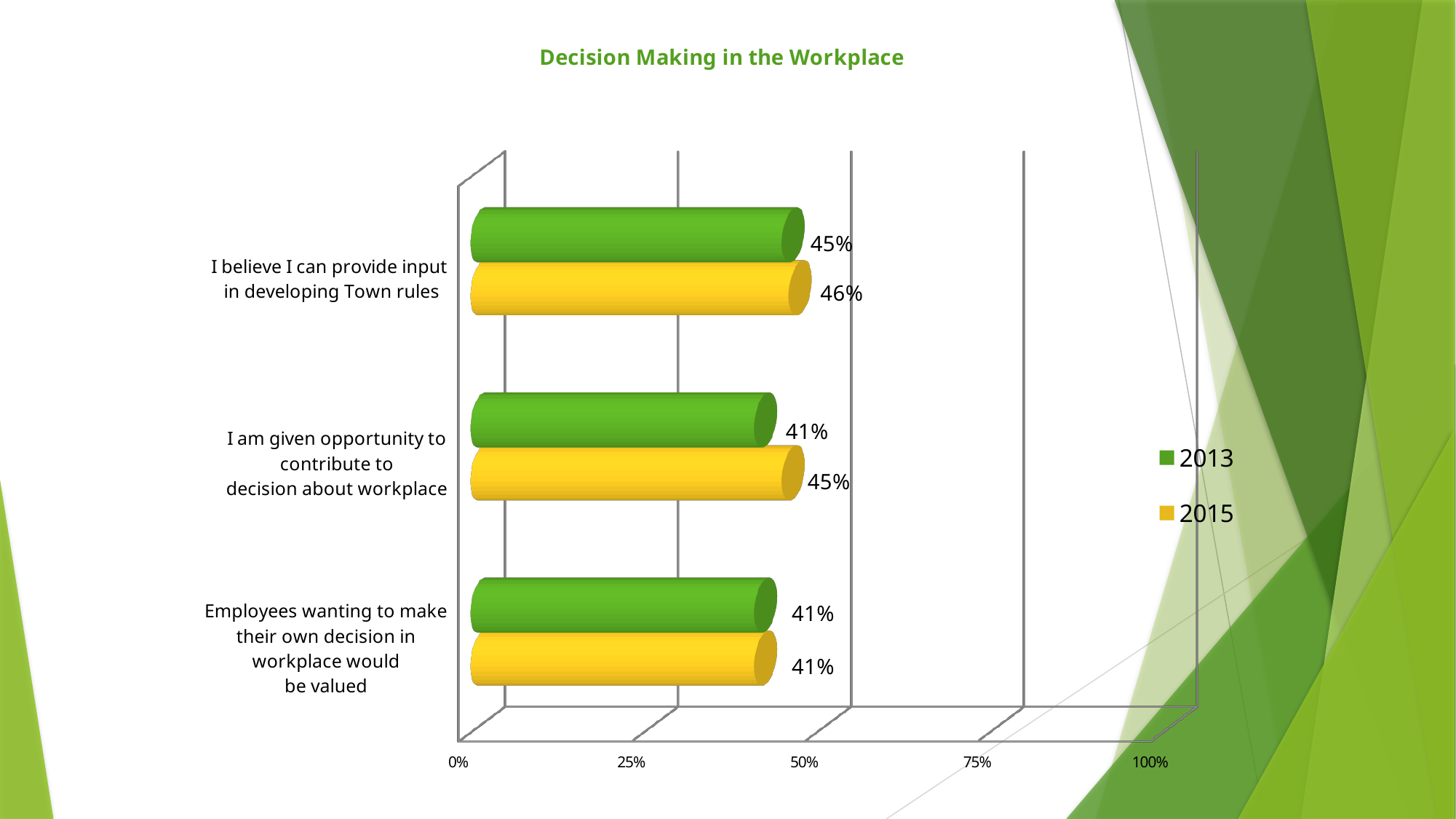
Which colour represents the 2015 series in the legend? Yellow How many categories are shown on the chart? 3 What is the 2015 value for "Employees wanting to make their own decision in workplace would be valued"? 41% What is the title of the chart? Decision Making in the Workplace For "I believe I can provide input in developing Town rules", which year has the larger value, 2013 or 2015? 2015 What is the 2013 value for "I believe I can provide input in developing Town rules"? 45% How many series does the legend list? 2 What kind of chart is shown on the slide? Bar chart Which category has the highest 2015 value? I believe I can provide input in developing Town rules What is the 2015 value for "I am given opportunity to contribute to decision about workplace"? 45% What is the difference between the 2015 and 2013 values for "I am given opportunity to contribute to decision about workplace"? 4% Is the 2013 value for "I believe I can provide input in developing Town rules" greater or less than 50%? less